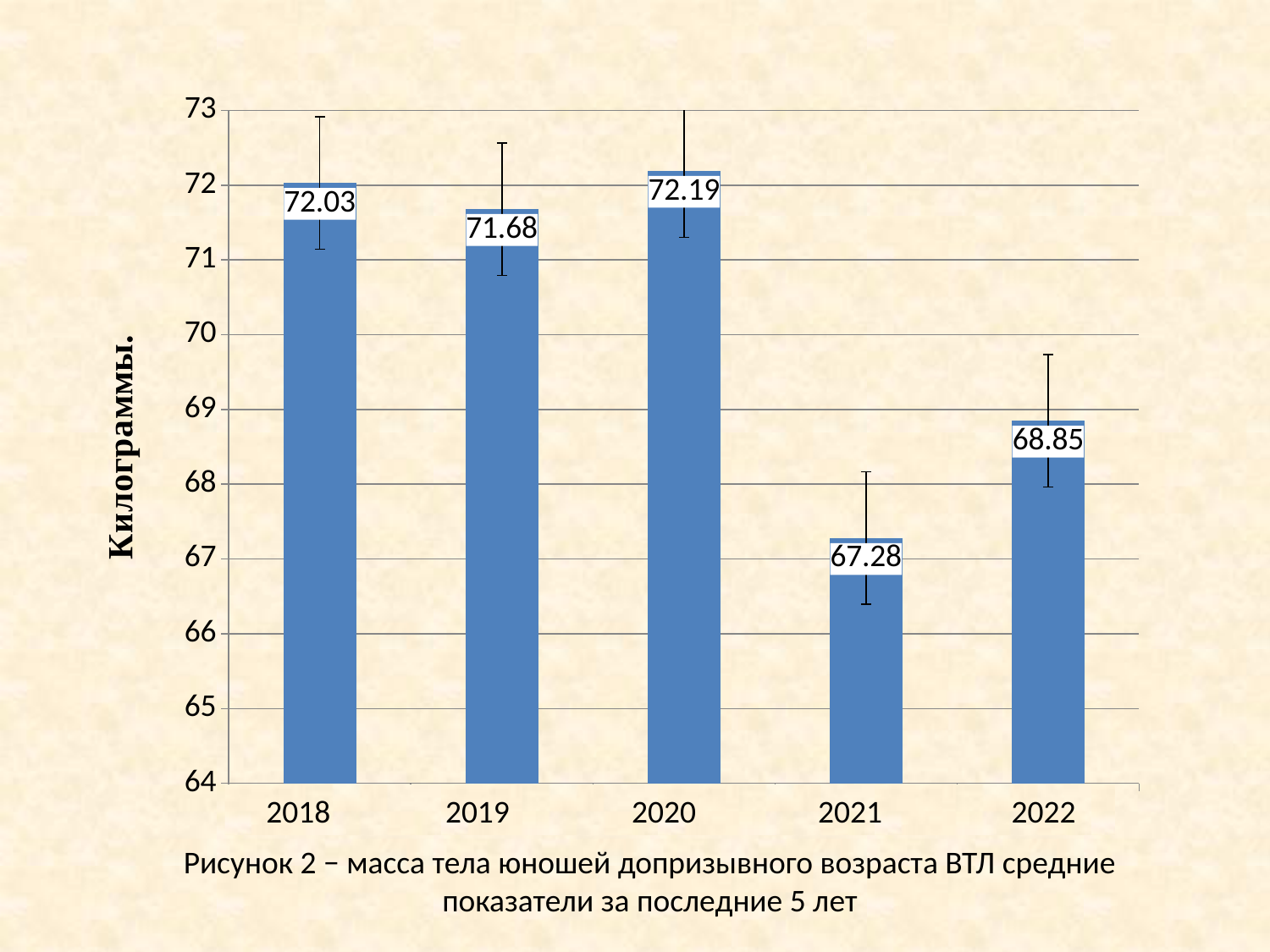
What is the value for 2021? 67.28 What is the difference between the values for 2020 and 2021? 4.91 What is the value for 2018? 72.03 Which year has the lowest value? 2021 What is the difference between the values for 2018 and 2019? 0.35 What kind of chart is this? bar chart How many years are shown on the x axis? 5 Which is larger, the value for 2019 or the value for 2022? 2019 What is the value for 2022? 68.85 What is the label of the vertical axis? Килограммы. Is the value for 2021 greater or less than 68? less Which year has the highest value? 2020